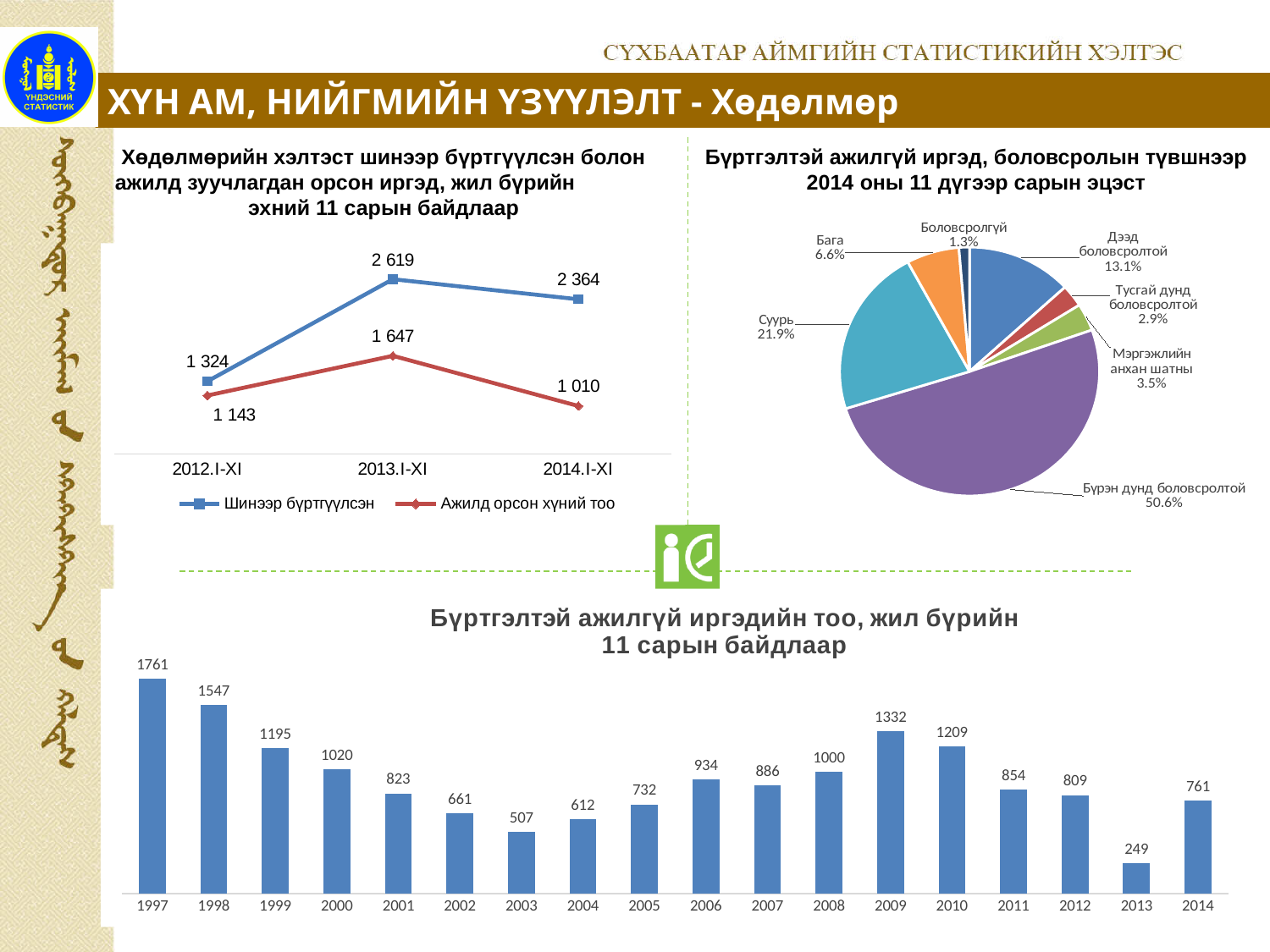
In the bottom bar chart, which year has the lowest value? 2013 How many series does the legend of the top-left line chart list? 2 In the top-right pie chart, which category has the smallest share? Боловсролгүй What kind of chart is the bottom chart titled 'Бүртгэлтэй ажилгүй иргэдийн тоо, жил бүрийн 11 сарын байдлаар'? Bar chart In the top-right pie chart, what share is Бүрэн дунд боловсролтой? 50.6% In the top-right pie chart, what is the share of Суурь? 21.9% In the bottom bar chart, which year has the highest value? 1997 In the bottom bar chart, what is the value for 2009? 1332 In the top-left line chart, what is the difference between Шинээр бүртгүүлсэн and Ажилд орсон хүний тоо for 2012.I-XI? 181 How many years are shown in the bottom bar chart? 18 In the top-left line chart, what is the value of Ажилд орсон хүний тоо for 2014.I-XI? 1 010 In the top-left line chart, what is the value of Шинээр бүртгүүлсэн for 2013.I-XI? 2 619